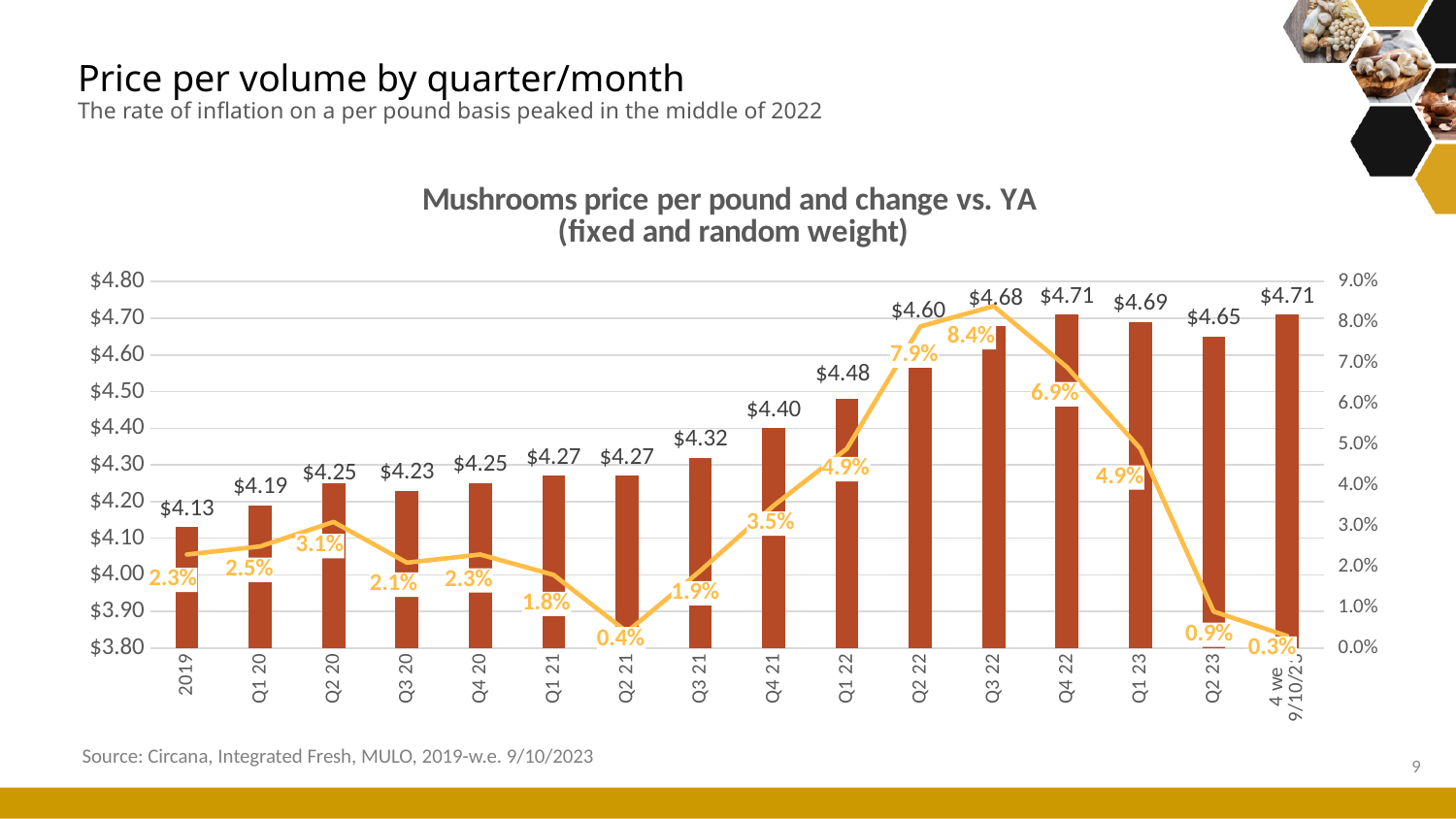
What is the change vs. YA shown for Q3 22? 8.4% Which period has the highest change vs. YA? Q3 22 What kind of chart is this? Bar chart with a line overlay What is the mushrooms price per pound for Q2 22? $4.60 What is the change vs. YA shown for Q1 23? 4.9% What is the title of the chart? Mushrooms price per pound and change vs. YA (fixed and random weight) What is the difference in price per pound between Q4 22 and 2019? $0.58 Which has the higher price per pound, Q3 21 or Q4 21? Q4 21 How many periods are shown on the x axis? 16 Which period has the lowest change vs. YA? 4 we 9/10/23 Does the price per pound rise or fall from 2019 to Q4 22? Rise Which period has the lowest price per pound? 2019